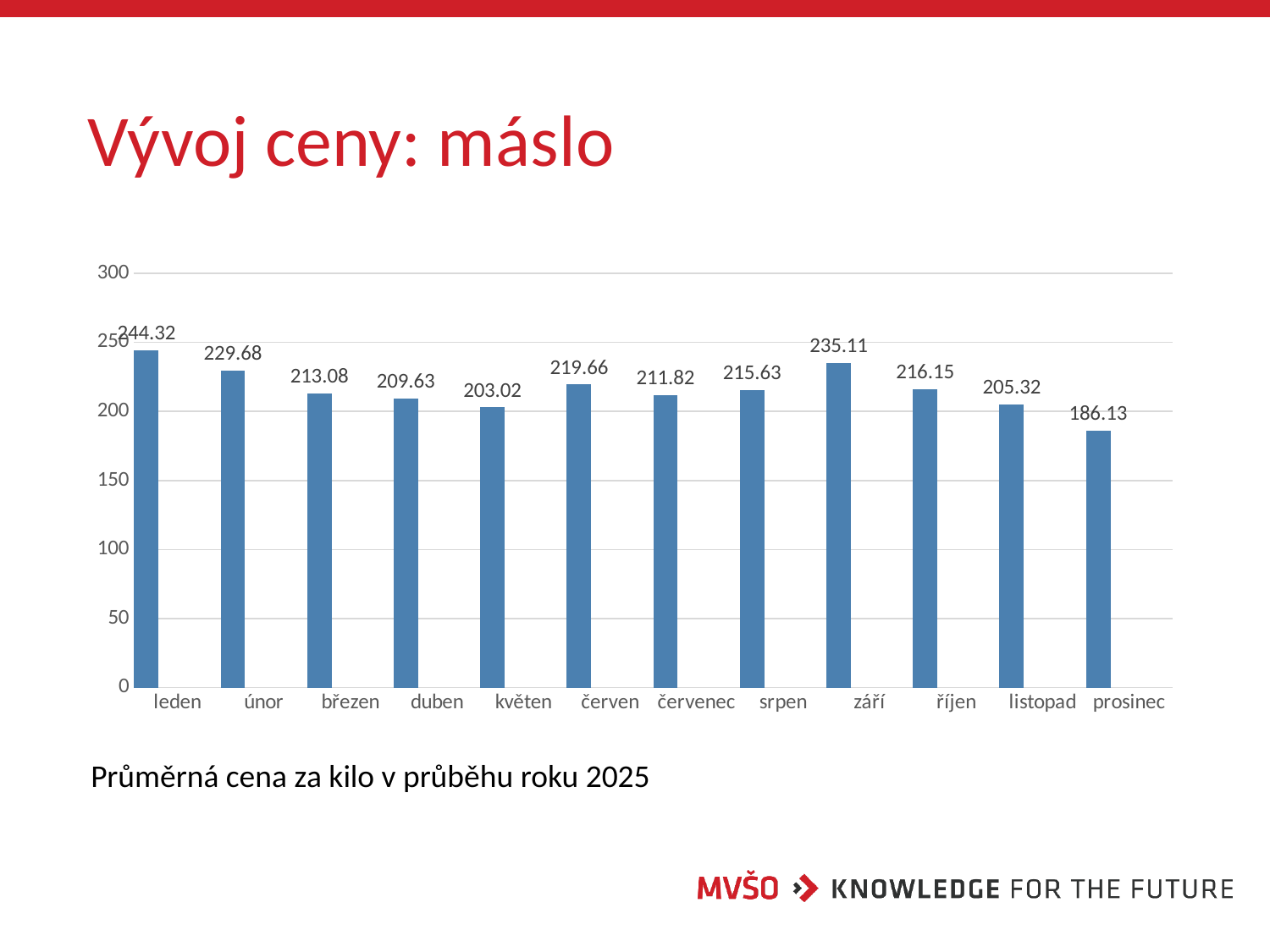
What is the value for leden? 244.32 What is the value for prosinec? 186.13 How many months are shown on the x axis? 12 Do the values rise or fall from září to prosinec? fall What is the value for září? 235.11 What kind of chart is shown on the slide? bar chart Which month has the lowest value? prosinec What is the difference between the values for leden and prosinec? 58.19 Which month has the highest value? leden What is the title of the slide? Vývoj ceny: máslo Which is larger, the value for únor or the value for září? září Is the value for květen greater or less than 250? less